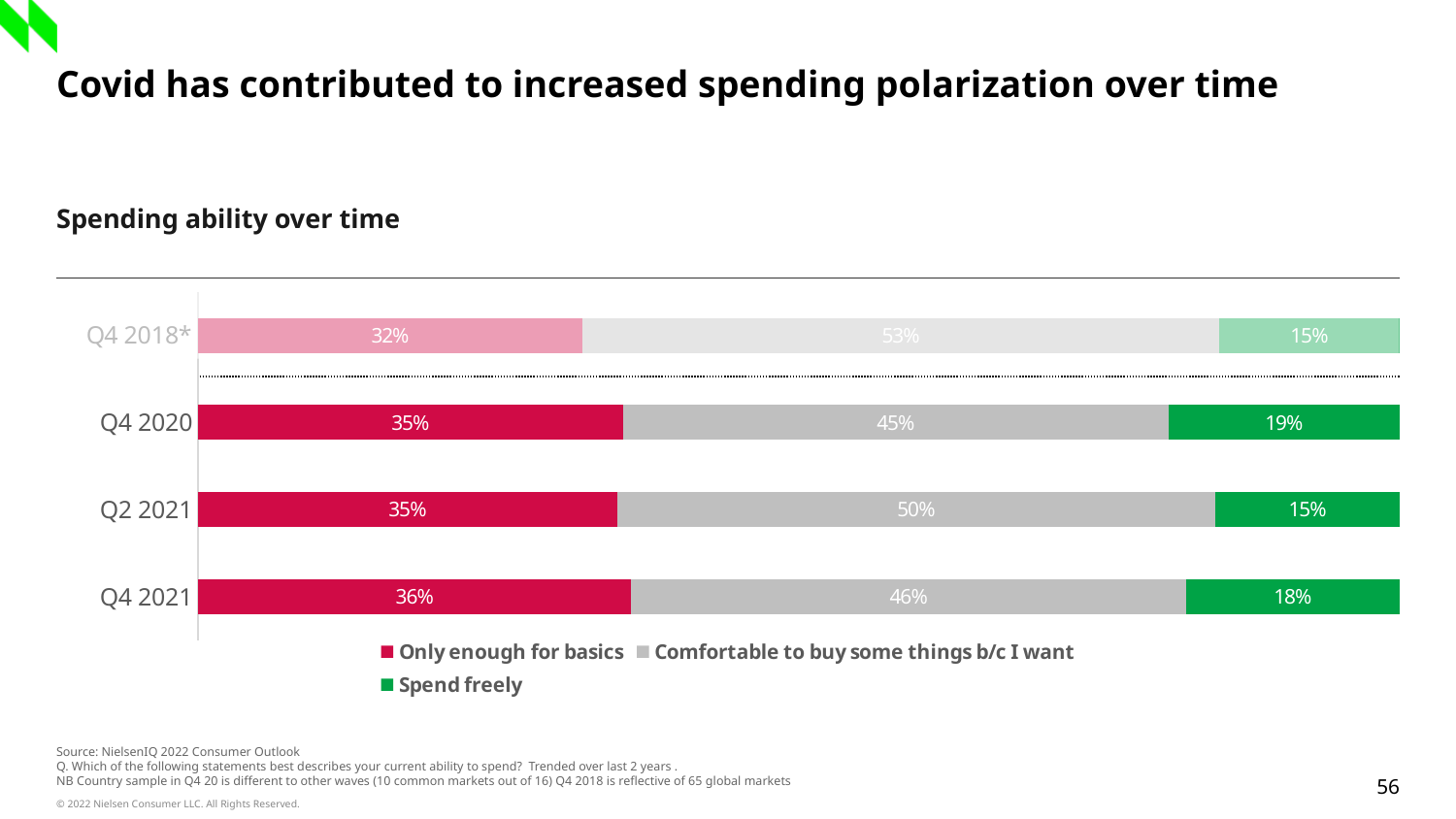
Which period has the lowest value for 'Only enough for basics'? Q4 2018* What type of chart is shown on the slide? Stacked bar chart How many time periods are shown in the chart? 4 How many series does the legend list? 3 What share of respondents in Q4 2018* were 'Comfortable to buy some things b/c I want'? 53% Is the 'Only enough for basics' value larger in Q4 2021 or in Q4 2018*? Q4 2021 What is the 'Spend freely' value for Q2 2021? 15% What percentage of respondents in Q4 2021 said they have only enough for basics? 36% What is the value for 'Spend freely' in Q4 2020? 19% What is the difference between the 'Spend freely' values for Q4 2020 and Q2 2021? 4 percentage points What is the title of the chart? Spending ability over time Which period has the highest value for 'Comfortable to buy some things b/c I want'? Q4 2018*